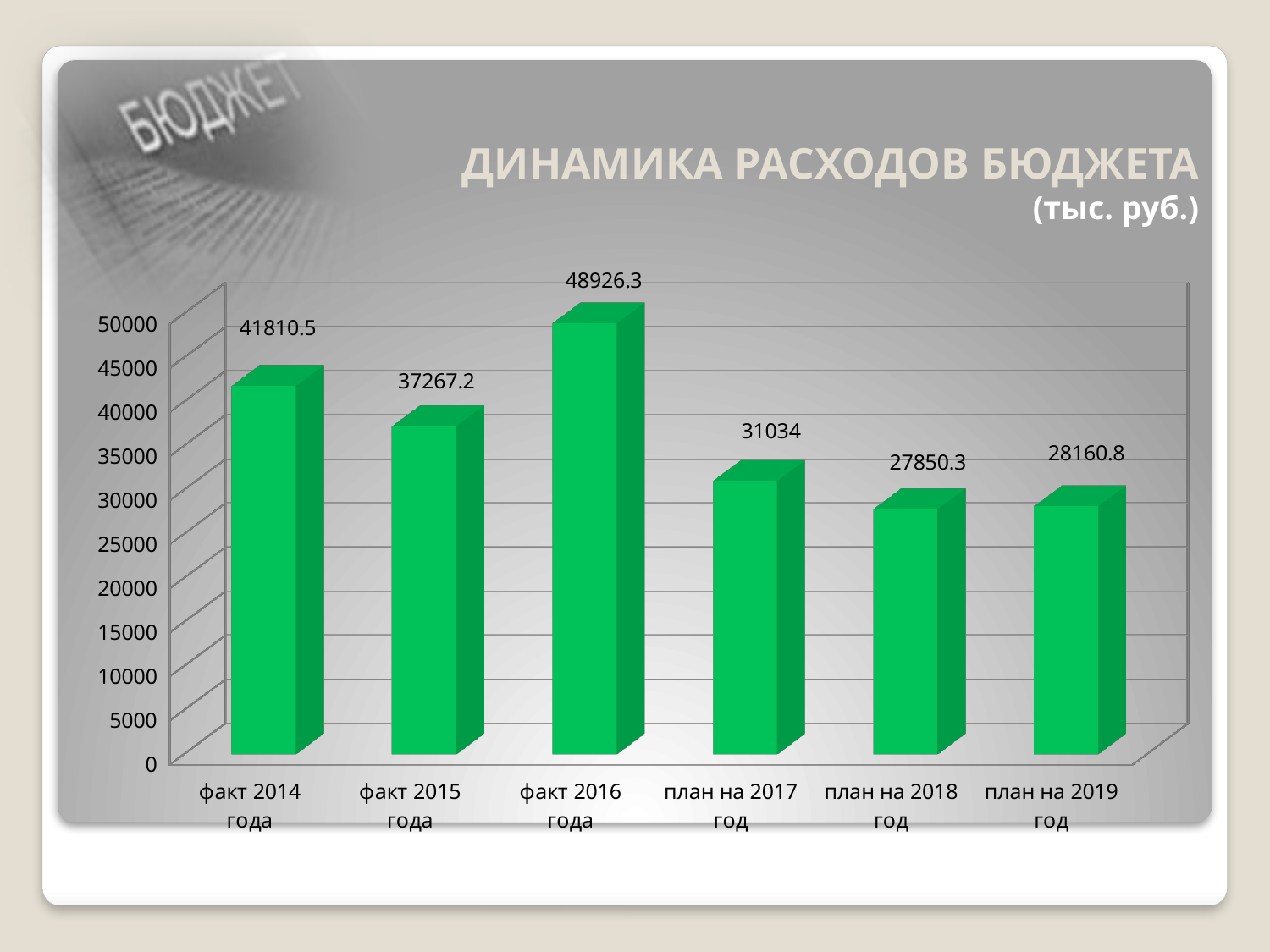
Do the values rise or fall from факт 2016 года to план на 2018 год? fall What is the difference between the values for факт 2016 года and факт 2014 года? 7115.8 Which is larger, the value for факт 2015 года or the value for план на 2017 год? факт 2015 года What is the value for план на 2017 год? 31034 What is the value for факт 2014 года? 41810.5 Which category has the highest value? факт 2016 года What is the difference between the values for план на 2019 год and план на 2018 год? 310.5 Is the value for план на 2017 год greater or less than 30000? greater Which category has the lowest value? план на 2018 год What kind of chart is shown on the slide? bar chart What is the value for план на 2018 год? 27850.3 How many categories are shown on the x axis? 6